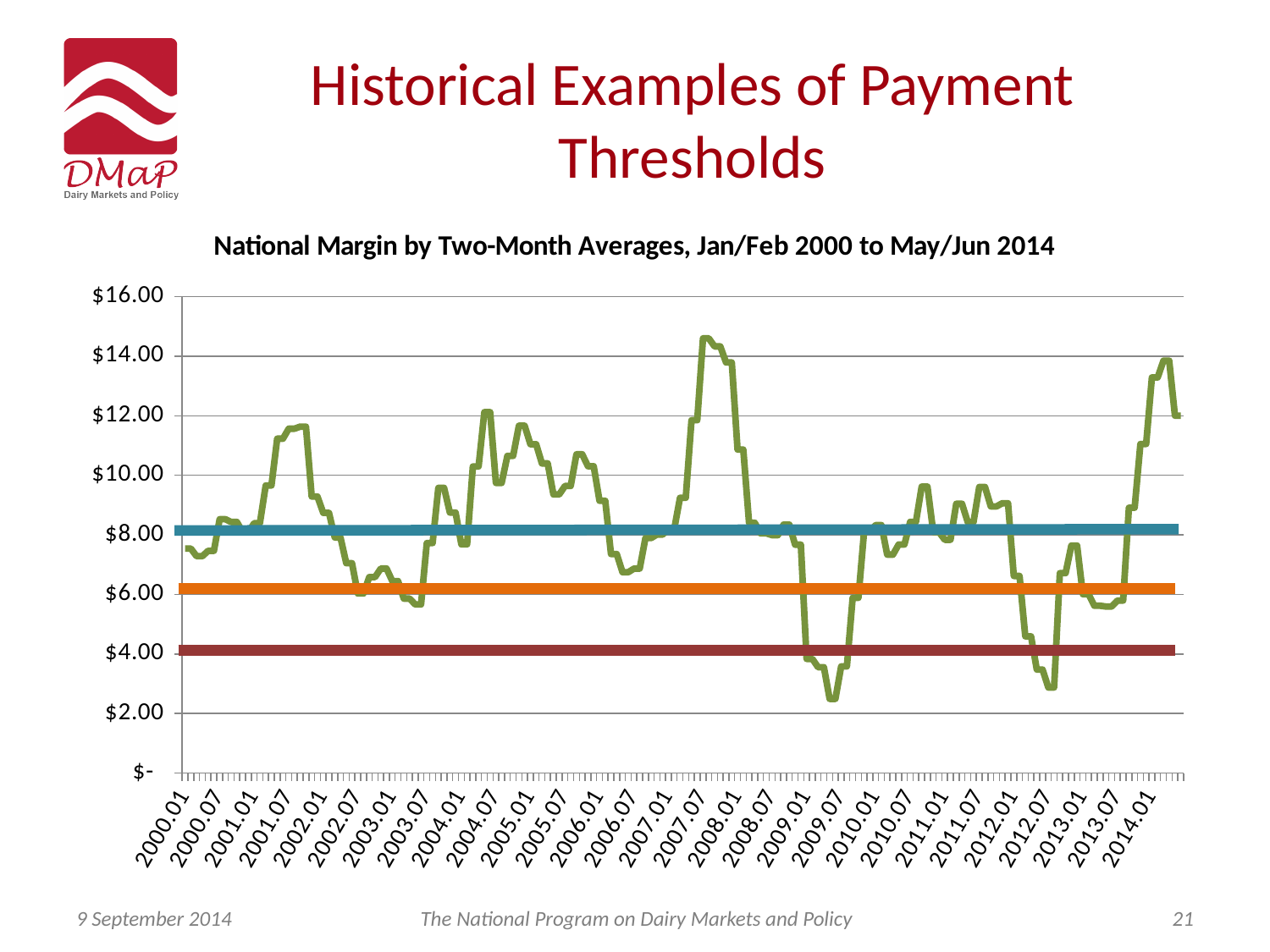
Is the national margin value at 2012.07 greater or less than $4.00? less Which of the three horizontal threshold lines is the highest on the chart? the blue line What is the title of the chart? National Margin by Two-Month Averages, Jan/Feb 2000 to May/Jun 2014 Is the highest point of the green national margin line greater or less than $14.00? greater Is the national margin value at 2006.07 greater or less than $8.00? less How many horizontal threshold lines are drawn across the chart? 3 Does the national margin rise or fall between 2013.07 and 2014.01? rise What is the highest value shown on the vertical axis? $16.00 What kind of chart is shown on the slide? line chart